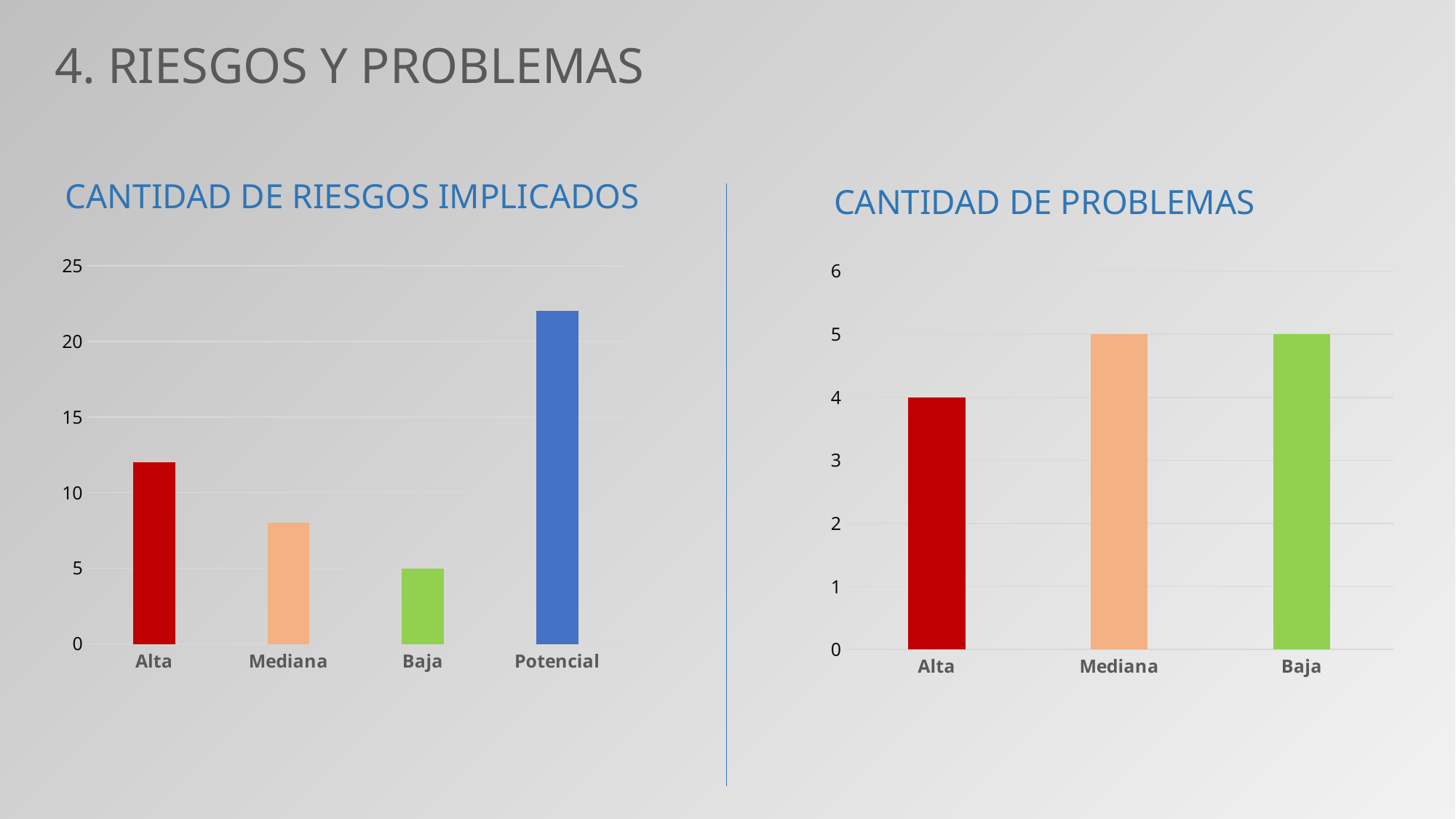
In the CANTIDAD DE PROBLEMAS chart, what is the value for Mediana? 5 In the CANTIDAD DE PROBLEMAS chart, what is the value for Alta? 4 In the CANTIDAD DE RIESGOS IMPLICADOS chart, what kind of chart is shown? bar chart In the CANTIDAD DE RIESGOS IMPLICADOS chart, what is the value for Baja? 5 In the CANTIDAD DE RIESGOS IMPLICADOS chart, is the value for Mediana greater or less than 10? less In the CANTIDAD DE RIESGOS IMPLICADOS chart, how many categories are plotted? 4 In the CANTIDAD DE RIESGOS IMPLICADOS chart, which is larger, Alta or Mediana? Alta In the CANTIDAD DE RIESGOS IMPLICADOS chart, is the value for Potencial greater or less than 20? greater In the CANTIDAD DE RIESGOS IMPLICADOS chart, which category has the highest value? Potencial In the CANTIDAD DE PROBLEMAS chart, which category has the lowest value? Alta In the CANTIDAD DE RIESGOS IMPLICADOS chart, which category has the lowest value? Baja In the CANTIDAD DE PROBLEMAS chart, what is the difference between the values for Baja and Alta? 1